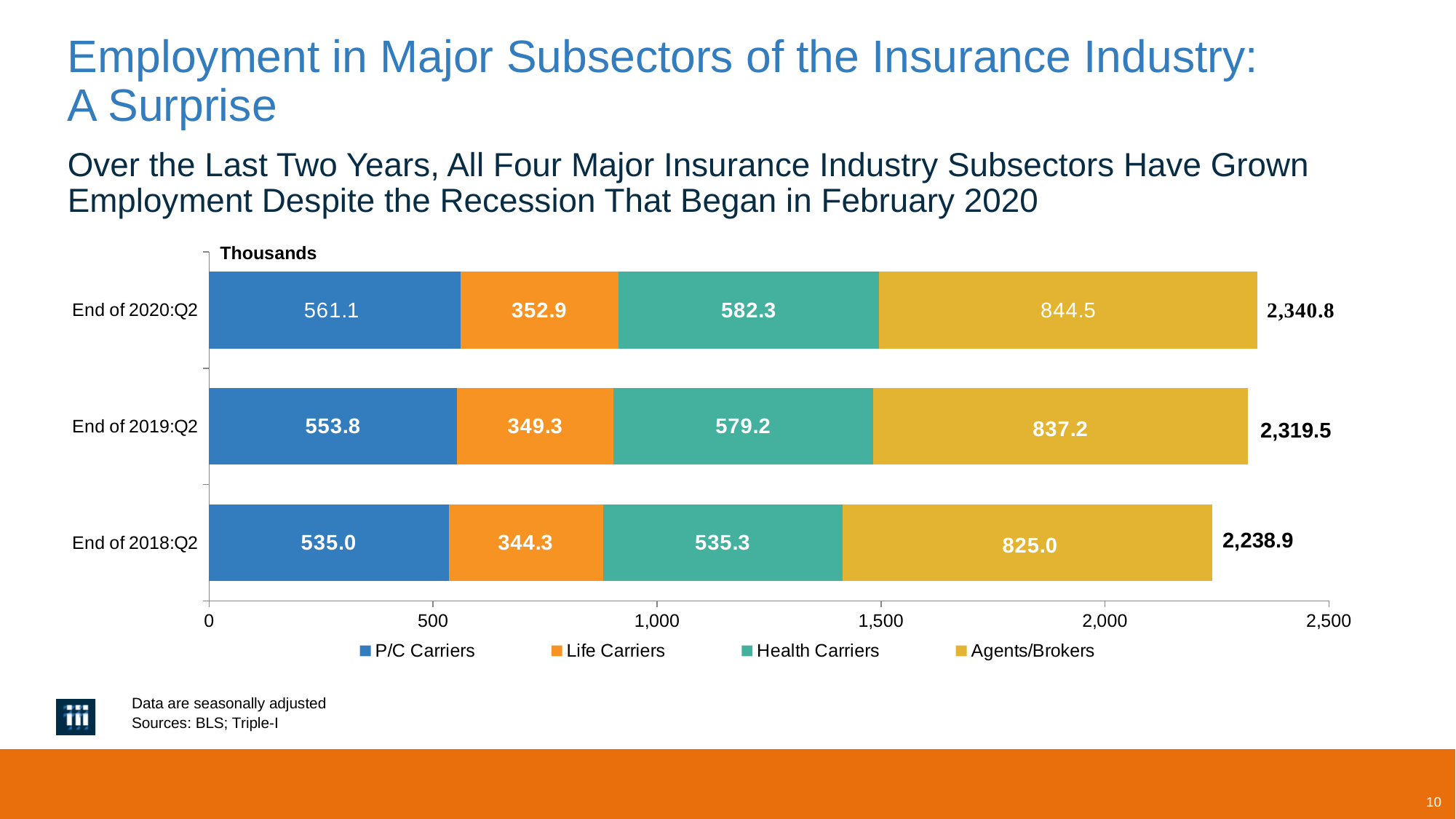
What is the difference between Agents/Brokers at End of 2020:Q2 and End of 2018:Q2? 19.5 What is the total employment shown for End of 2018:Q2? 2,238.9 What unit is indicated at the top of the chart? Thousands Which subsector has the lowest value at End of 2019:Q2? Life Carriers Which period has the highest total employment? End of 2020:Q2 What is the value for P/C Carriers at End of 2020:Q2? 561.1 Which is larger at End of 2018:Q2, P/C Carriers or Health Carriers? Health Carriers What is the value for Agents/Brokers at End of 2018:Q2? 825.0 What is the total employment shown for End of 2020:Q2? 2,340.8 What kind of chart is shown on the slide? Stacked bar chart What is the value for Health Carriers at End of 2019:Q2? 579.2 How many series does the legend list? 4